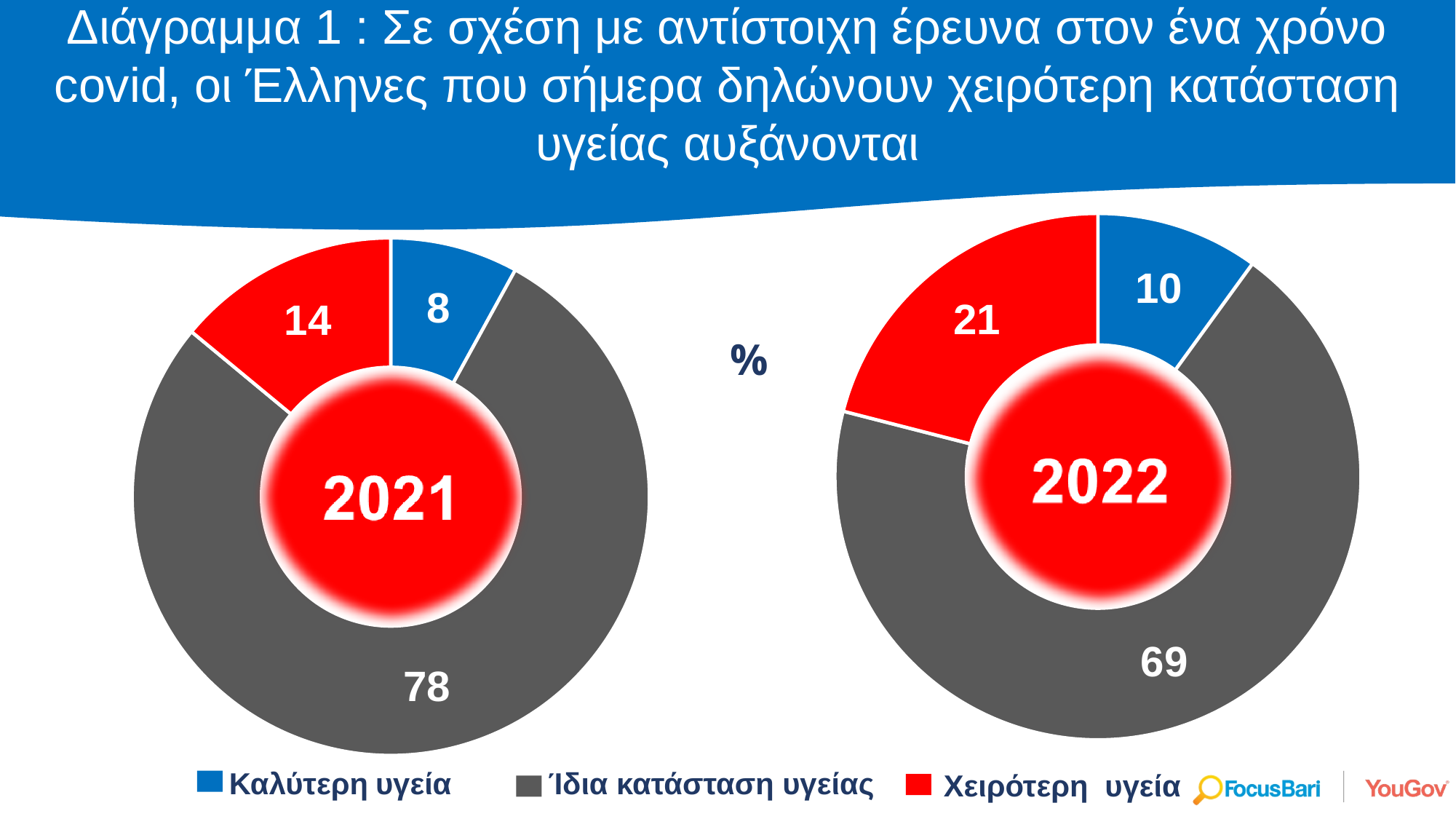
In the 2021 chart, which category has the smallest slice? Καλύτερη υγεία What is the difference between Ίδια κατάσταση υγείας and Καλύτερη υγεία in the 2021 chart? 70 In the 2021 chart, which category has the largest slice? Ίδια κατάσταση υγείας In the 2021 chart, what is the value for Χειρότερη υγεία? 14 In the 2022 chart, what is the value for Καλύτερη υγεία? 10 What is the difference between the Χειρότερη υγεία value in the 2022 chart and in the 2021 chart? 7 In the 2022 chart, what is the value for Ίδια κατάσταση υγείας? 69 How many slices does the 2022 chart have? 3 What colour represents Χειρότερη υγεία in the legend? Red Which is larger: Ίδια κατάσταση υγείας in the 2021 chart or in the 2022 chart? 2021 What type of chart is used on this slide? Doughnut (pie) chart How many categories does the legend list? 3